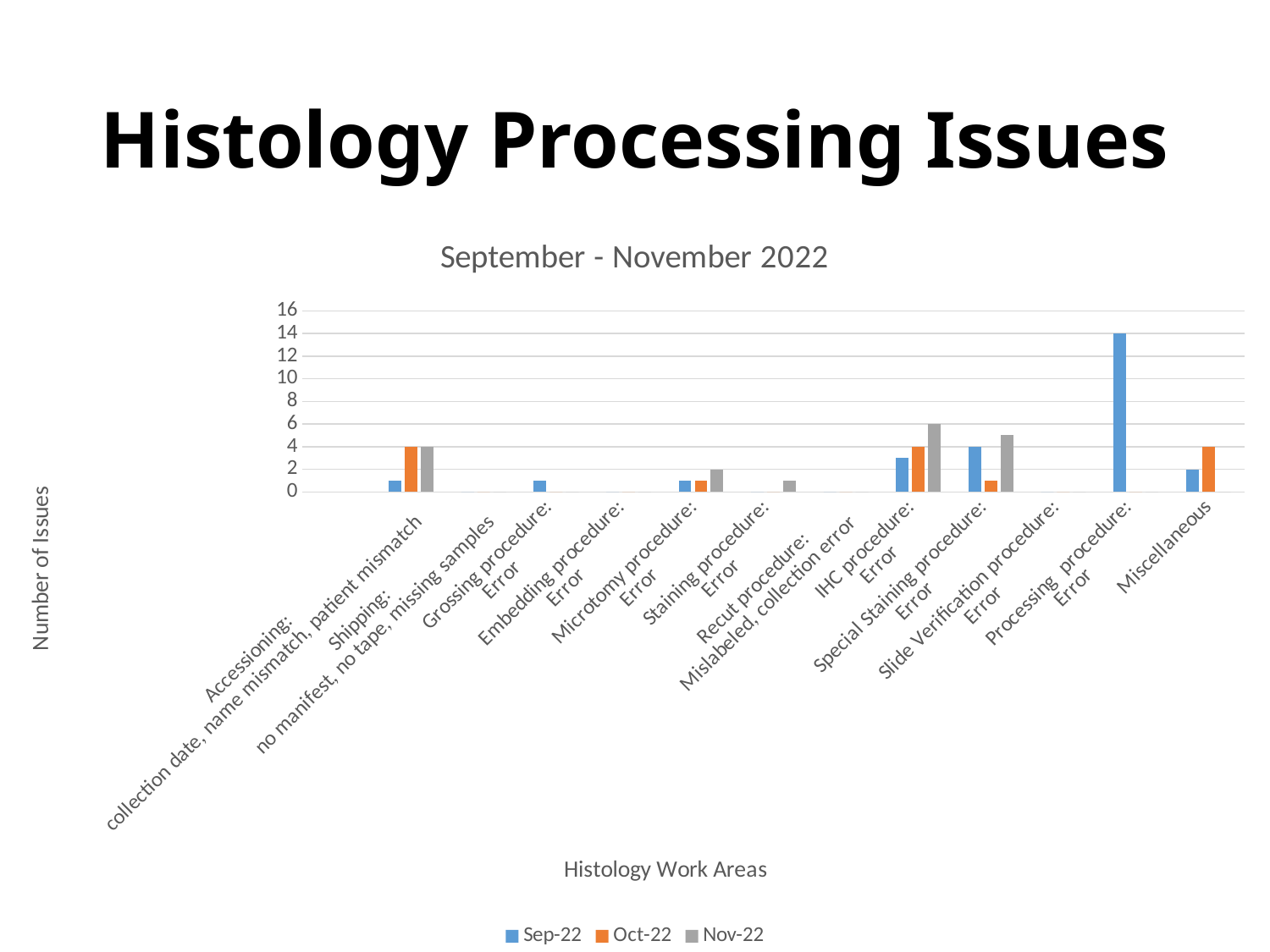
What kind of chart is shown on the slide? bar chart What is the title of the chart? September - November 2022 What is the difference between the Sep-22 value for Processing procedure: Error and the Nov-22 value for IHC procedure: Error? 8 Is the Sep-22 value for IHC procedure: Error greater or less than 4? less What is the Nov-22 value for IHC procedure: Error? 6 How many series does the legend list? 3 What is the Sep-22 value for Processing procedure: Error? 14 Which is larger: the Sep-22 value for Processing procedure: Error or the Nov-22 value for IHC procedure: Error? Sep-22 value for Processing procedure: Error What is the Oct-22 value for Miscellaneous? 4 Is the Nov-22 value for Special Staining procedure: Error greater or less than 4? greater How many histology work area categories are shown on the x axis? 12 Which category has the highest Sep-22 bar? Processing procedure: Error